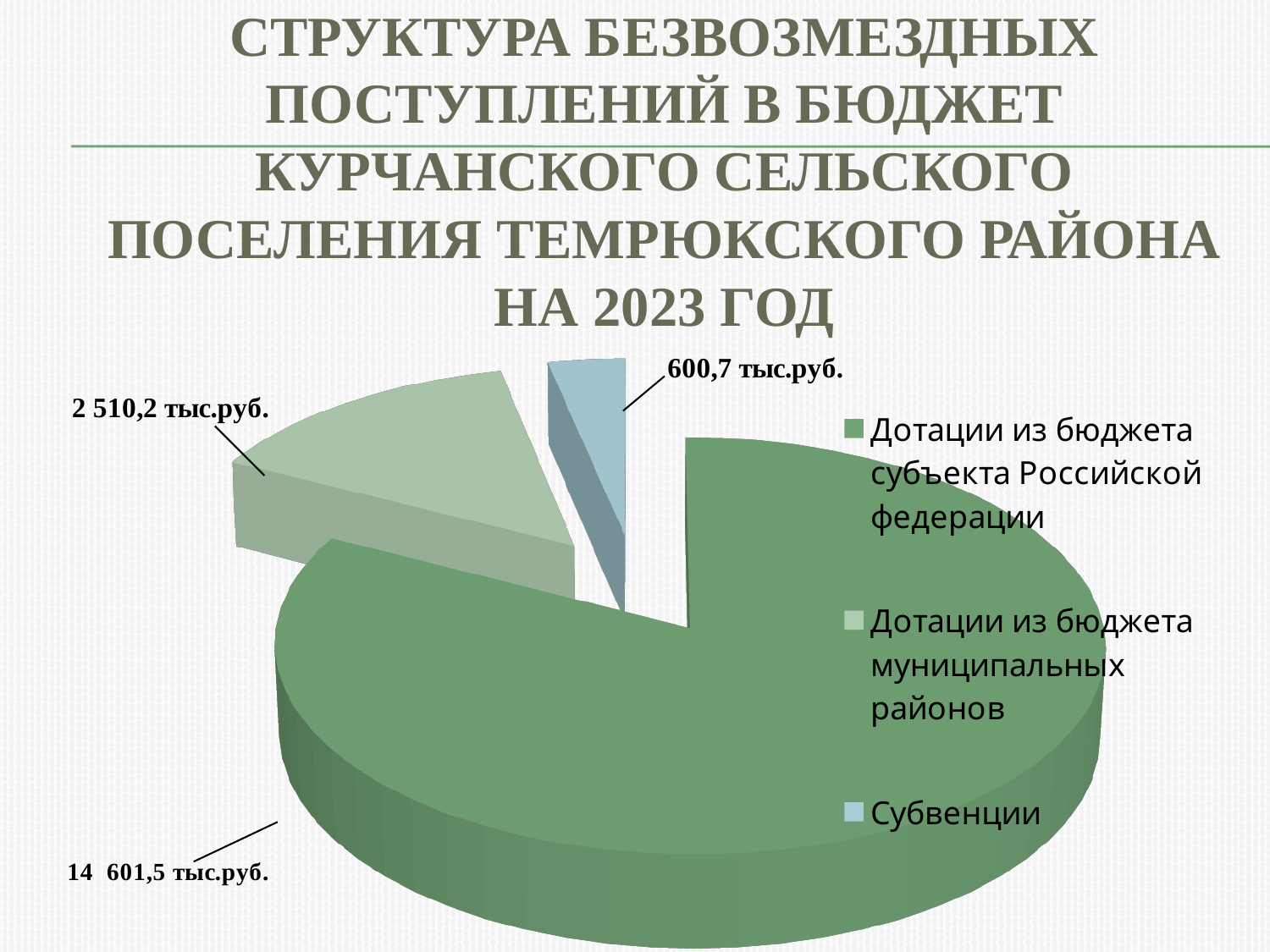
How many entries does the legend list? 3 How many slices does the pie chart have? 3 What is the value for Дотации из бюджета муниципальных районов? 2 510,2 тыс.руб. What kind of chart is shown on the slide? pie chart What colour is the slice for Субвенции? light blue What is the value for Дотации из бюджета субъекта Российской федерации? 14 601,5 тыс.руб. Which category has the largest slice of the pie? Дотации из бюджета субъекта Российской федерации What is the difference between Дотации из бюджета муниципальных районов and Субвенции? 1 909,5 тыс.руб. What is the value for Субвенции? 600,7 тыс.руб. What is the difference between Дотации из бюджета субъекта Российской федерации and Дотации из бюджета муниципальных районов? 12 091,3 тыс.руб. Which category has the smallest slice of the pie? Субвенции Which is larger: Дотации из бюджета муниципальных районов or Субвенции? Дотации из бюджета муниципальных районов